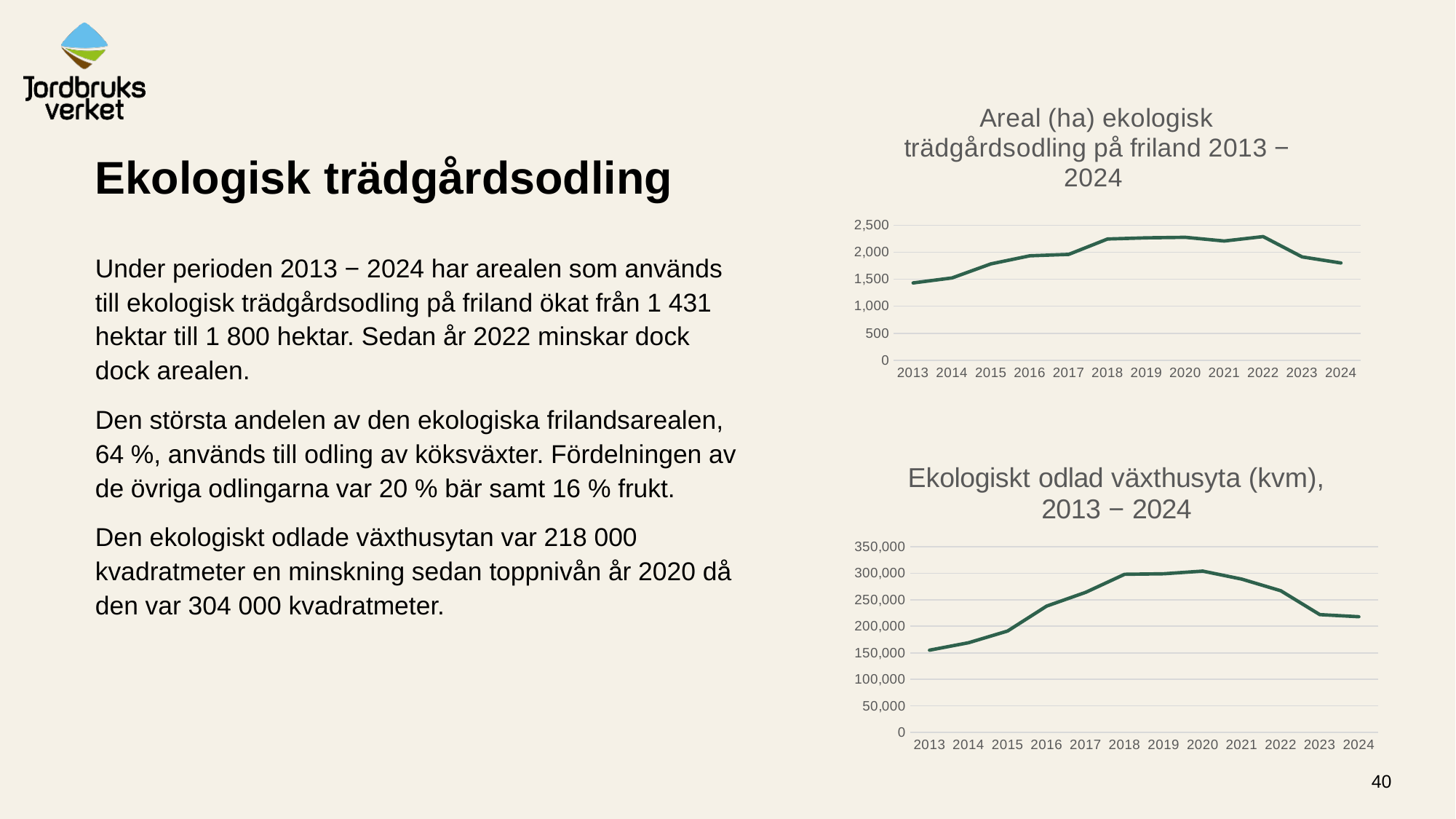
In the top chart (Areal ekologisk trädgårdsodling på friland), is the value for 2024 greater or less than 2,000? less In the top chart (Areal ekologisk trädgårdsodling på friland), does the value rise or fall from 2013 to 2018? rise In the top chart (Areal ekologisk trädgårdsodling på friland), which year has the lowest value? 2013 In the top chart (Areal ekologisk trädgårdsodling på friland), is the value for 2013 greater or less than 1,500? less In the bottom chart (Ekologiskt odlad växthusyta), which year has the highest value? 2020 How many years are plotted on the x axis of the top chart (Areal ekologisk trädgårdsodling på friland)? 12 In the top chart (Areal ekologisk trädgårdsodling på friland), is the value for 2019 greater or less than 2,000? greater In the bottom chart (Ekologiskt odlad växthusyta), which year has the lowest value? 2013 What kind of chart is the top chart, 'Areal (ha) ekologisk trädgårdsodling på friland 2013 − 2024'? line chart In the bottom chart (Ekologiskt odlad växthusyta), does the value rise or fall from 2020 to 2024? fall